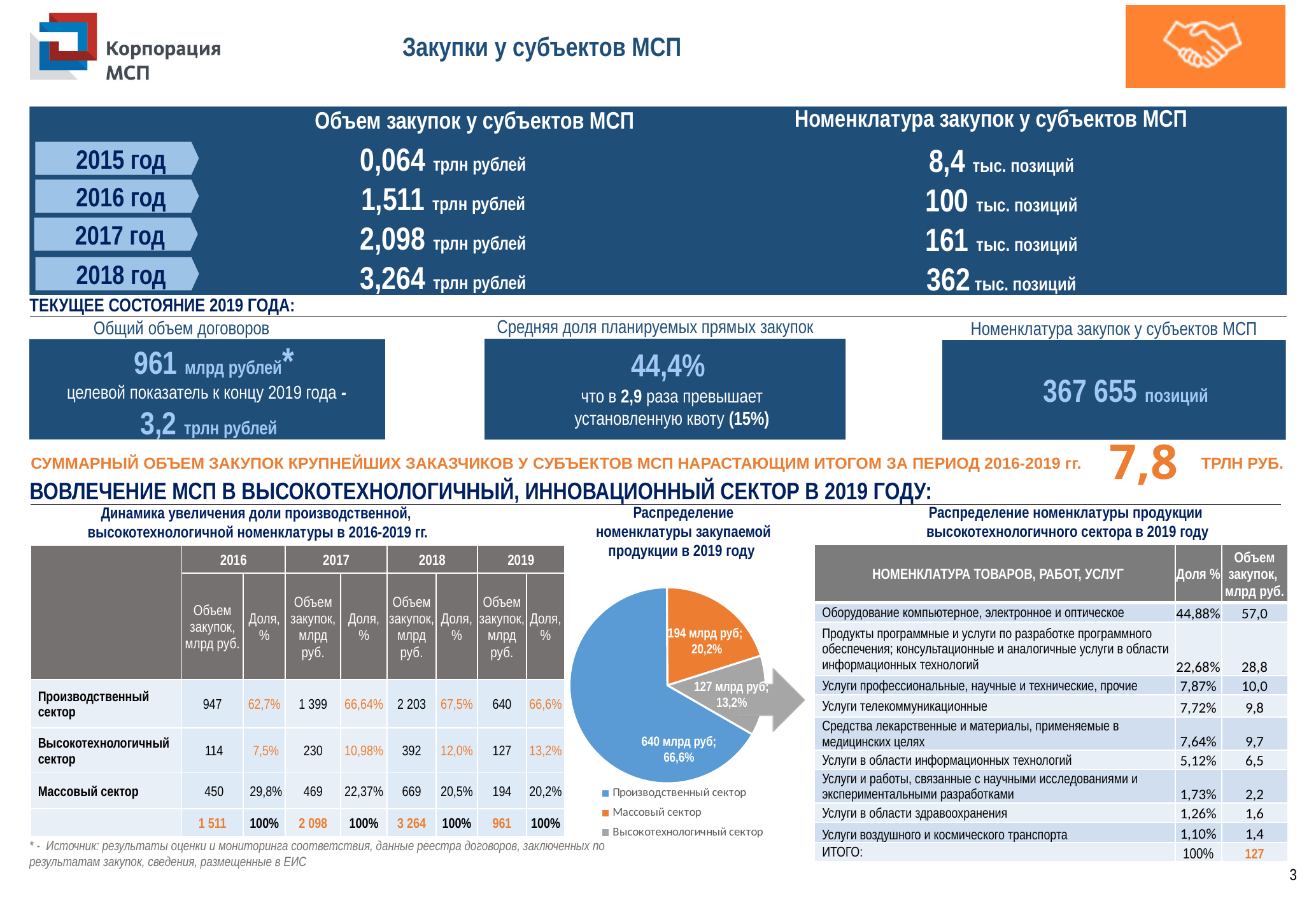
In the pie chart "Распределение номенклатуры закупаемой продукции в 2019 году", which sector has the largest slice? Производственный сектор In the pie chart "Распределение номенклатуры закупаемой продукции в 2019 году", which sector has the smallest slice? Высокотехнологичный сектор In the pie chart "Распределение номенклатуры закупаемой продукции в 2019 году", what share of the pie does Массовый сектор take? 20,2% What kind of chart is shown under the title "Распределение номенклатуры закупаемой продукции в 2019 году"? pie chart In the pie chart "Распределение номенклатуры закупаемой продукции в 2019 году", what is the difference in млрд руб between Производственный сектор and Массовый сектор? 446 млрд руб In the pie chart "Распределение номенклатуры закупаемой продукции в 2019 году", what colour is the slice for Высокотехнологичный сектор? grey In the pie chart "Распределение номенклатуры закупаемой продукции в 2019 году", how many slices are there? 3 In the pie chart "Распределение номенклатуры закупаемой продукции в 2019 году", what is the value for Производственный сектор? 640 млрд руб; 66,6% In the pie chart "Распределение номенклатуры закупаемой продукции в 2019 году", which is larger: Массовый сектор or Высокотехнологичный сектор? Массовый сектор In the pie chart "Распределение номенклатуры закупаемой продукции в 2019 году", what is the value for Высокотехнологичный сектор? 127 млрд руб; 13,2% In the pie chart "Распределение номенклатуры закупаемой продукции в 2019 году", how many entries does the legend list? 3 In the pie chart "Распределение номенклатуры закупаемой продукции в 2019 году", what is the value for Массовый сектор? 194 млрд руб; 20,2%